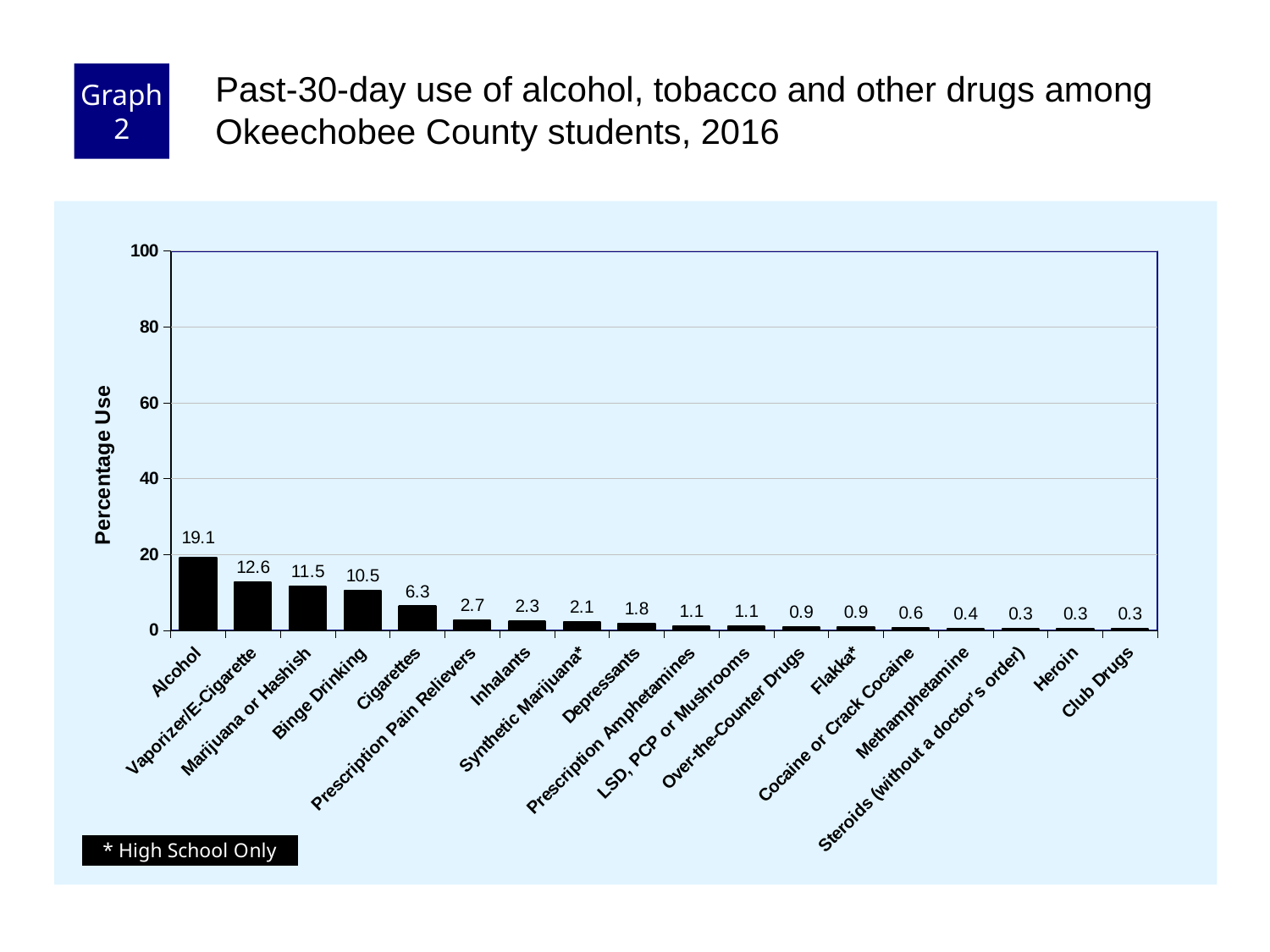
What is the percentage use for Alcohol? 19.1 What is the percentage use for Binge Drinking? 10.5 What is the percentage use for Vaporizer/E-Cigarette? 12.6 What kind of chart is shown on the slide? Bar chart How many categories are shown on the x axis? 18 What is the difference in percentage use between Marijuana or Hashish and Binge Drinking? 1.0 Which has a higher percentage use, Prescription Pain Relievers or Depressants? Prescription Pain Relievers Which category has the highest percentage use? Alcohol What is the difference in percentage use between Alcohol and Cigarettes? 12.8 Is the value for Alcohol greater or less than 20? less What is the label of the y axis? Percentage Use What is the percentage use for Inhalants? 2.3